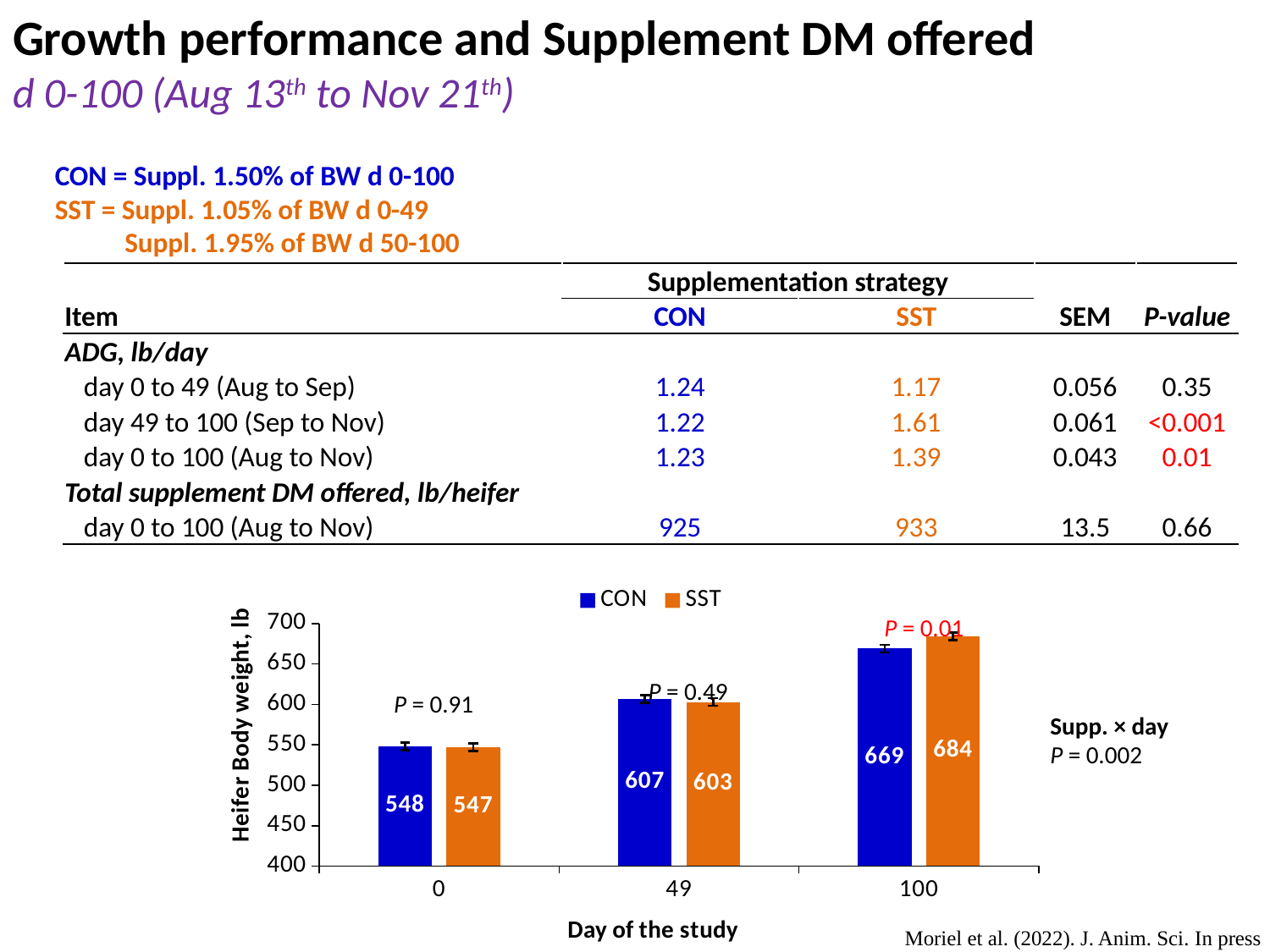
What kind of chart is shown on the slide? bar chart Which is larger at day 49, the CON or the SST body weight? CON At which day of the study is the CON body weight highest? 100 What is the heifer body weight for SST at day 100? 684 At which day of the study is the SST body weight lowest? 0 How many series does the chart legend list? 2 Is the CON body weight at day 100 greater or less than 650? greater What is the heifer body weight for CON at day 0? 548 How many day-of-study categories are shown on the x axis? 3 What is the heifer body weight for SST at day 49? 603 Do the CON body weights rise or fall from day 0 to day 100? rise What is the difference between the SST and CON body weights at day 100? 15